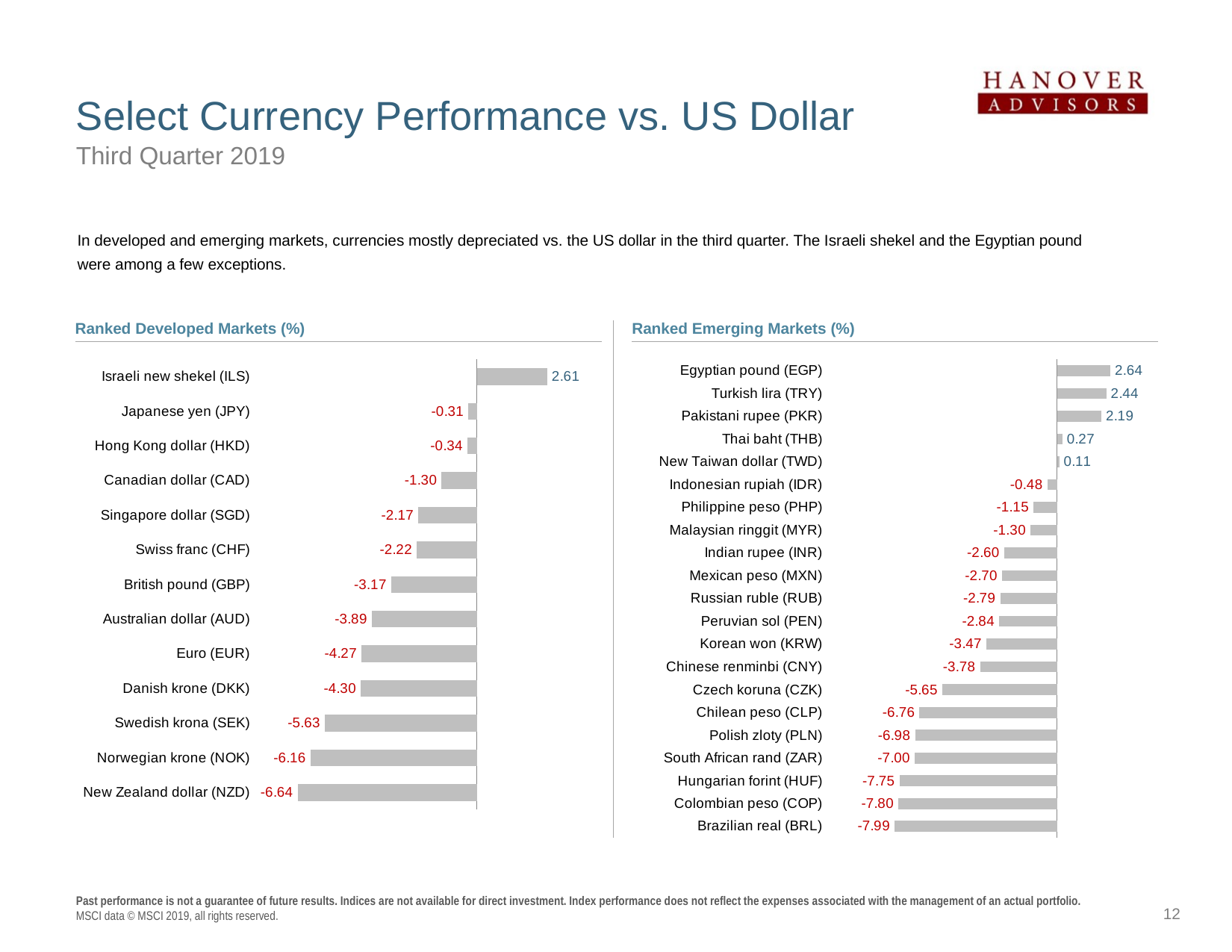
What type of chart is the Ranked Emerging Markets (%) chart? Bar chart How many currencies are shown in the Ranked Emerging Markets (%) chart? 21 How many currencies are shown in the Ranked Developed Markets (%) chart? 13 In the Ranked Emerging Markets (%) chart, which currency has the highest value? Egyptian pound (EGP) In the Ranked Developed Markets (%) chart, what is the difference between the values for the Euro (EUR) and the Danish krone (DKK)? 0.03 In the Ranked Emerging Markets (%) chart, how many currencies have positive values? 5 In the Ranked Developed Markets (%) chart, which currency has the lowest value? New Zealand dollar (NZD) In the Ranked Developed Markets (%) chart, what is the value for the Israeli new shekel (ILS)? 2.61 In the Ranked Emerging Markets (%) chart, what is the difference between the values for the Egyptian pound (EGP) and the Brazilian real (BRL)? 10.63 In the Ranked Emerging Markets (%) chart, which is larger, the value for the Turkish lira (TRY) or the Pakistani rupee (PKR)? Turkish lira (TRY) In the Ranked Developed Markets (%) chart, what is the value for the British pound (GBP)? -3.17 In the Ranked Emerging Markets (%) chart, what is the value for the Brazilian real (BRL)? -7.99